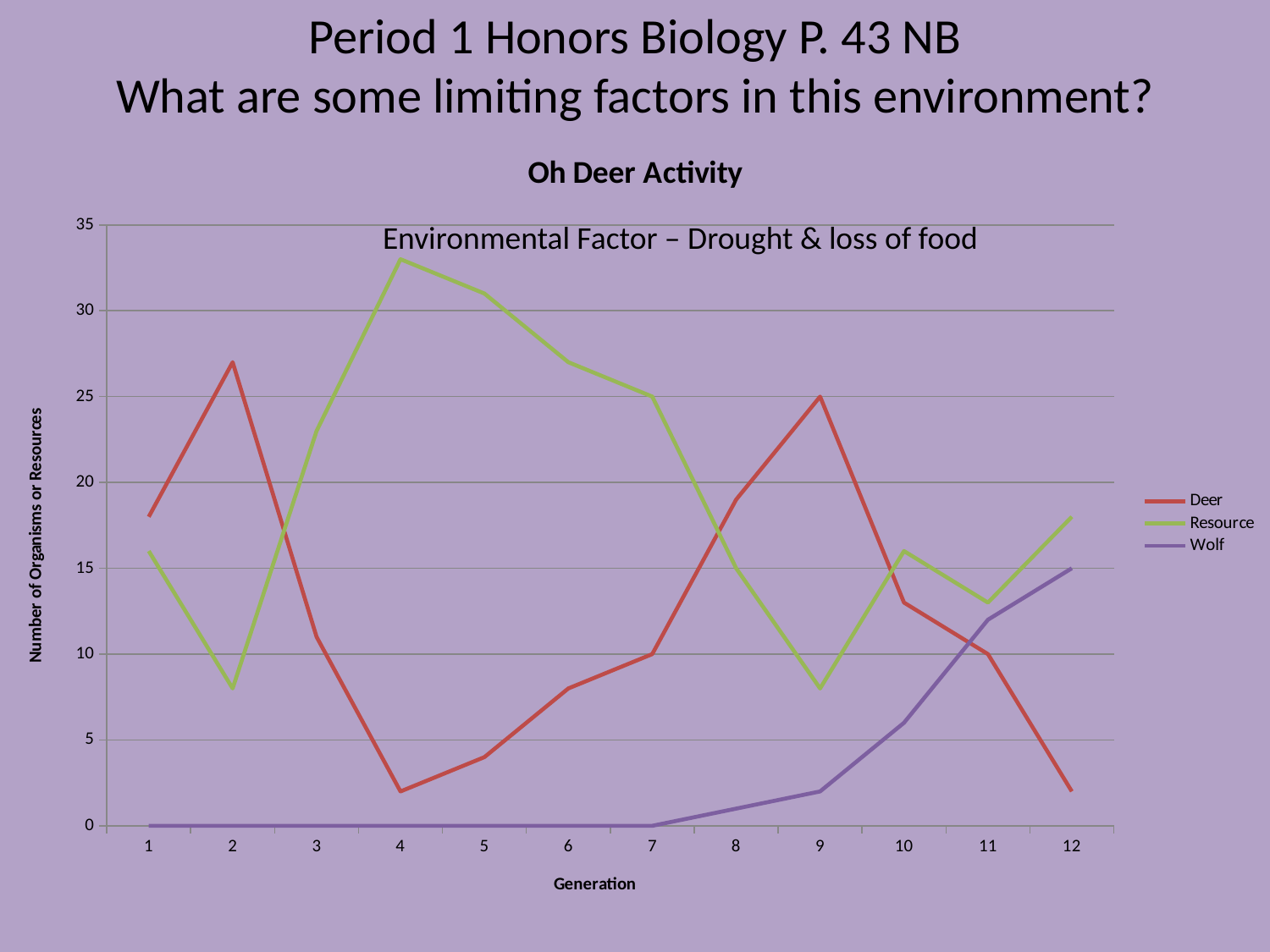
What is the Deer value at generation 9? 25 Does the Wolf series rise or fall from generation 7 to generation 12? Rise At which generation does the Deer series reach its highest value? 2 Is the Deer value at generation 4 greater or less than 5? less What is the Deer value at generation 7? 10 At which generation does the Resource series reach its highest value? 4 At generation 4, which is larger, the Deer value or the Resource value? Resource How many generations are plotted along the x axis? 12 What kind of chart is shown on the slide? Line chart What is the Wolf value at generation 1? 0 How many series does the legend list? 3 Is the Resource value at generation 4 greater or less than 30? greater